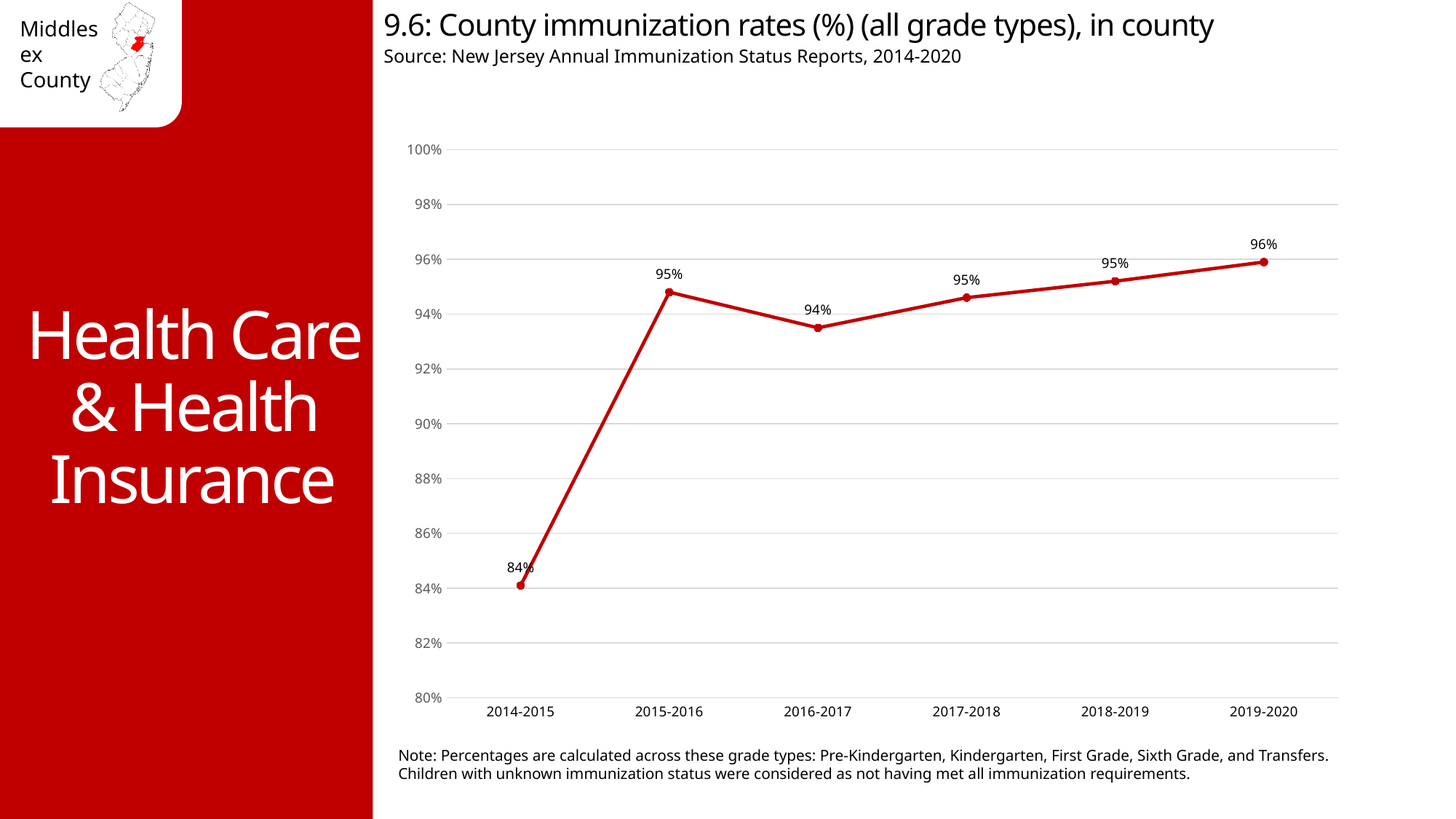
Which school year has the highest immunization rate? 2019-2020 How many school years are plotted on the chart? 6 What kind of chart is shown on the slide? line chart Which has a higher immunization rate, 2014-2015 or 2016-2017? 2016-2017 What is the difference in immunization rate between 2019-2020 and 2014-2015? 12 percentage points What is the county immunization rate for 2016-2017? 94% Which school year has the lowest immunization rate? 2014-2015 What is the county immunization rate for 2019-2020? 96% Does the immunization rate rise or fall from 2014-2015 to 2019-2020? rise Is the immunization rate for 2014-2015 greater or less than 86%? less What is the county immunization rate for 2017-2018? 95% What is the county immunization rate for 2014-2015? 84%